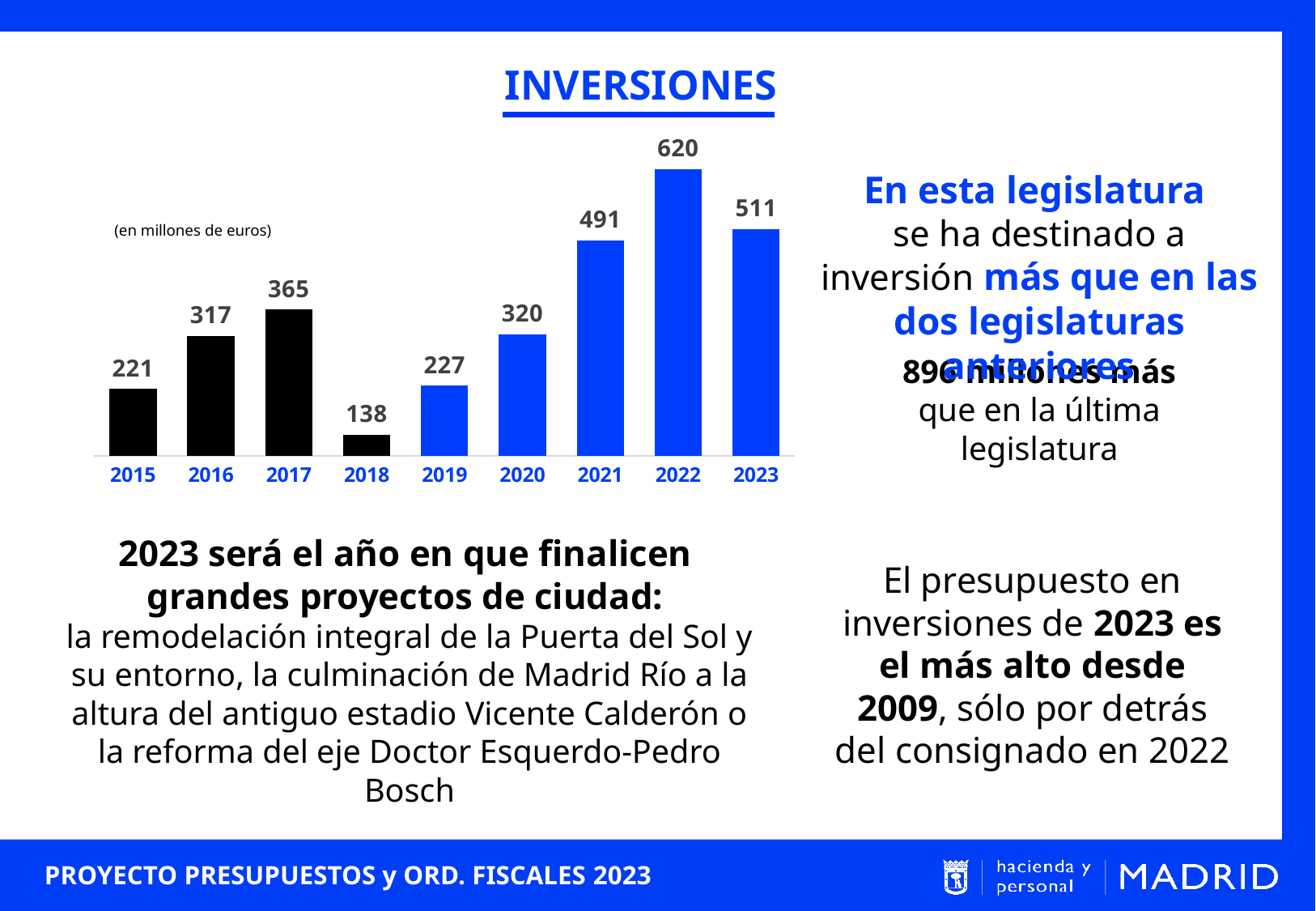
Which year has the highest value in the INVERSIONES chart? 2022 What is the value for 2018 in the INVERSIONES chart? 138 Do the values in the INVERSIONES chart rise or fall from 2018 to 2022? rise What is the value for 2022 in the INVERSIONES chart? 620 What unit is stated for the values in the INVERSIONES chart? en millones de euros Which year has the lowest value in the INVERSIONES chart? 2018 What is the value for 2023 in the INVERSIONES chart? 511 Which is larger in the INVERSIONES chart, the value for 2017 or the value for 2020? 2017 How many years are shown in the INVERSIONES chart? 9 What kind of chart is the INVERSIONES chart? bar chart What colour are the bars for 2019 to 2023 in the INVERSIONES chart? blue What is the difference between the values for 2022 and 2023 in the INVERSIONES chart? 109